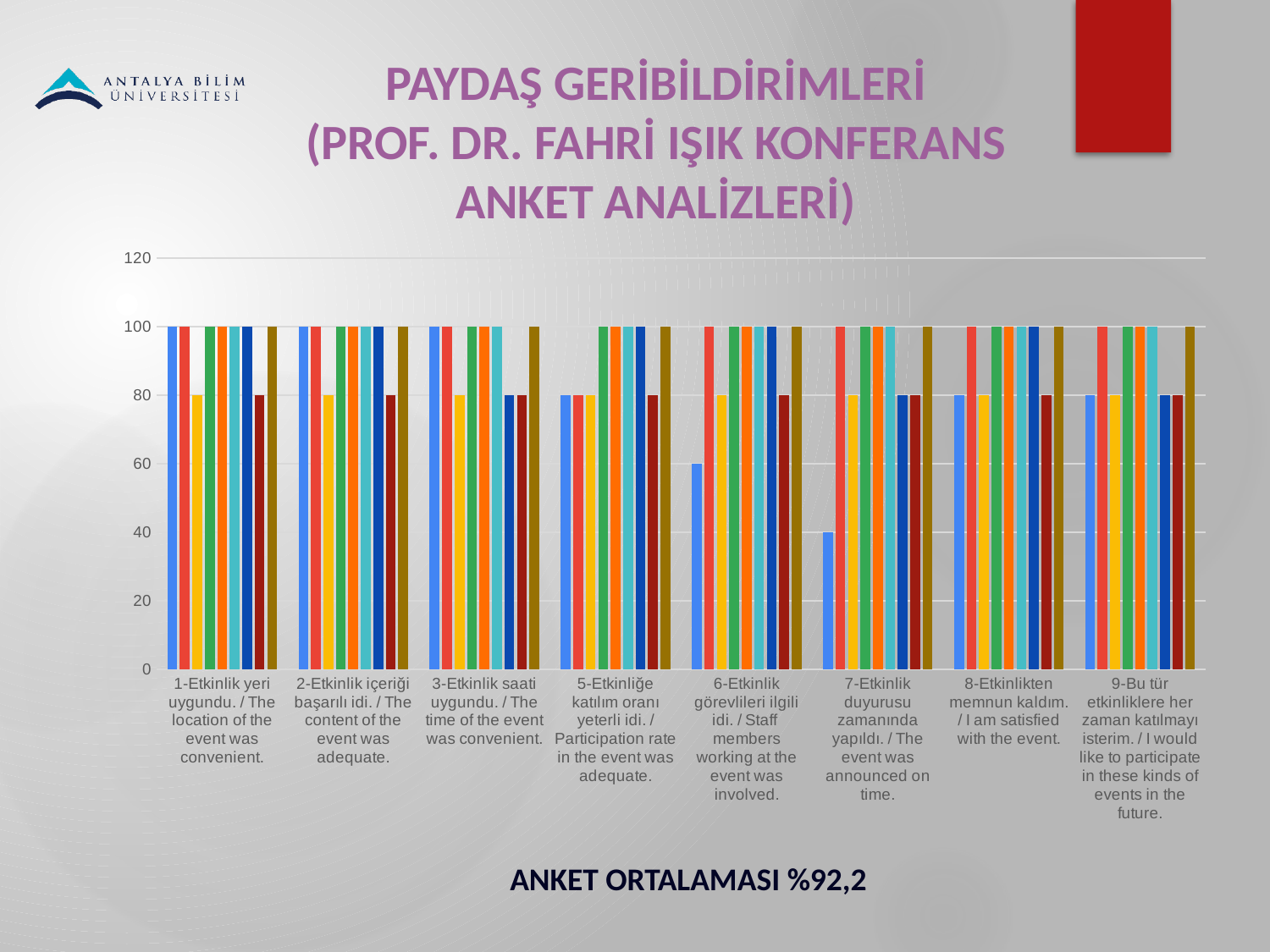
Which category is listed first on the x axis? 1-Etkinlik yeri uygundu. / The location of the event was convenient. What survey average (ANKET ORTALAMASI) is stated below the chart? %92,2 Is the first (leftmost) bar in the category '1-Etkinlik yeri uygundu.' greater or less than 80? greater How many categories (survey questions) are shown along the x axis? 8 What is the highest value shown on the vertical axis? 120 How many bars are plotted for each category? 9 Is the first (leftmost) bar in the category '6-Etkinlik görevlileri ilgili idi.' greater or less than 80? less Is the first (leftmost) bar in the category '7-Etkinlik duyurusu zamanında yapıldı.' greater or less than 60? less In which category does the lowest bar of the chart appear? 7-Etkinlik duyurusu zamanında yapıldı. / The event was announced on time. What is the lowest value reached by any bar in the chart? 40 What is the highest value reached by any bar in the chart? 100 What kind of chart is shown on the slide? bar chart